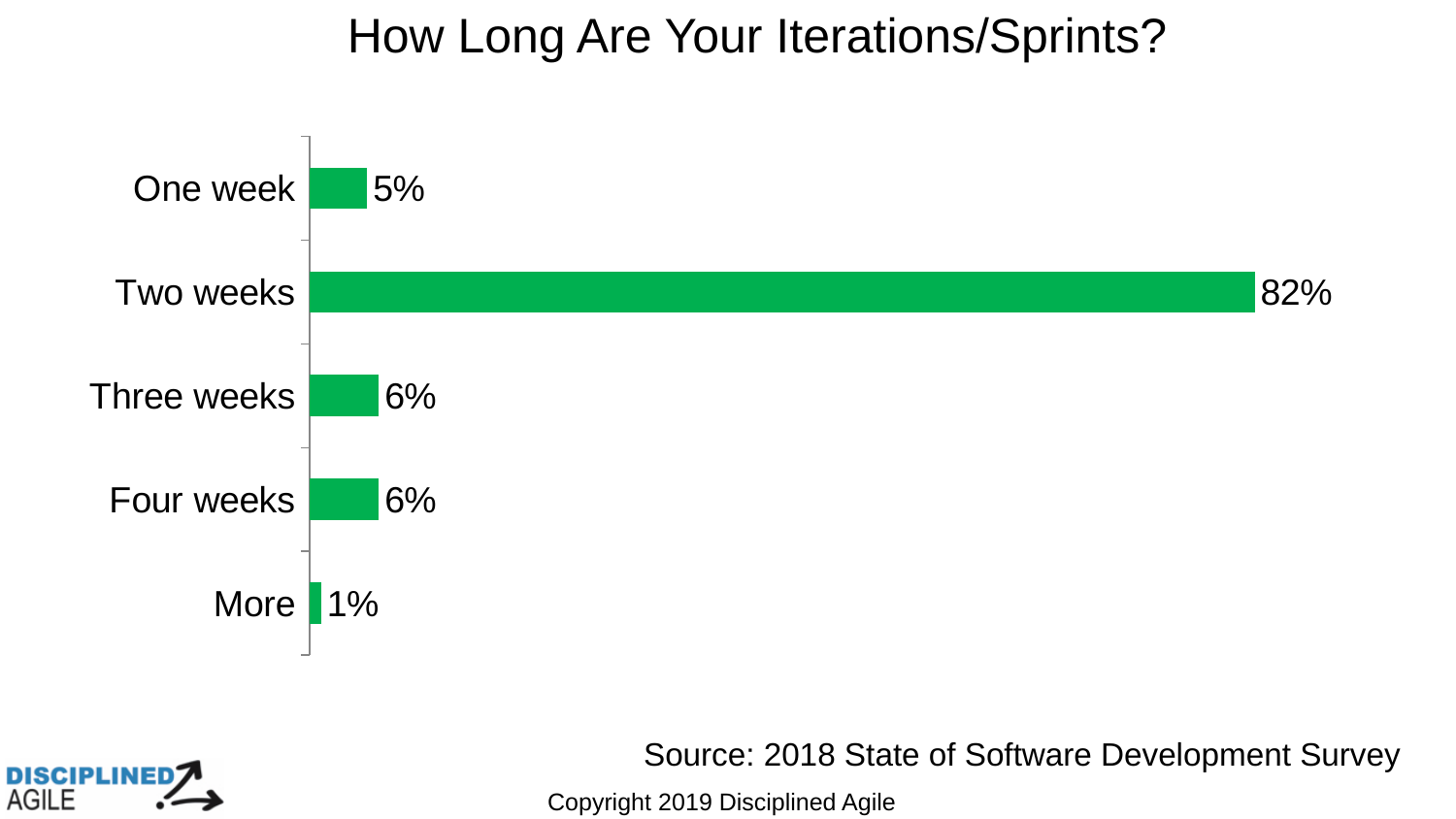
Which category has the lowest percentage? More How many categories are shown in the chart? 5 Which is larger, the value for Three weeks or the value for One week? Three weeks What is the difference between the values for Two weeks and One week? 77% What is the difference between the values for Four weeks and More? 5% What is the value for One week? 5% What kind of chart is shown on the slide? Bar chart What is the value for More? 1% What is the value for Three weeks? 6% Which iteration length has the highest percentage? Two weeks What is the title of the chart? How Long Are Your Iterations/Sprints? What percentage of respondents have two-week iterations/sprints? 82%